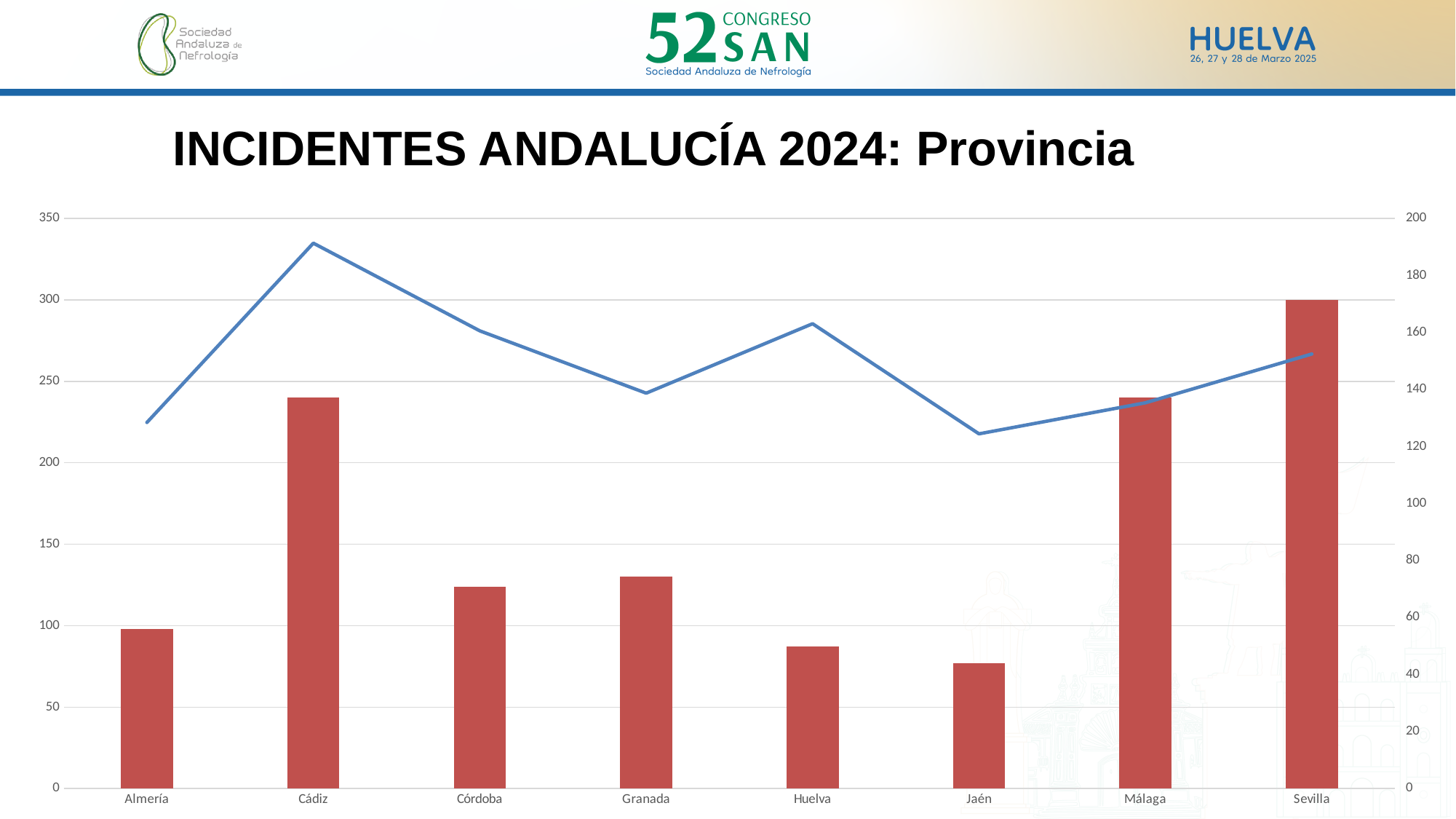
Does the blue line rise or fall from Jaén to Sevilla? rise What is the title of the chart on the slide? INCIDENTES ANDALUCÍA 2024: Provincia Which province has the shortest bar in the chart? Jaén Which province has the tallest bar in the chart? Sevilla How many provinces are shown on the x axis of the chart? 8 Which province has a taller bar, Cádiz or Córdoba? Cádiz What kind of chart is shown on the slide? A bar chart combined with a line At which province does the blue line reach its highest point? Cádiz Is the blue line value for Cádiz greater or less than 180 on the right axis? greater Is the bar for Granada greater or less than 100 on the left axis? greater Is the bar for Sevilla greater or less than 250 on the left axis? greater